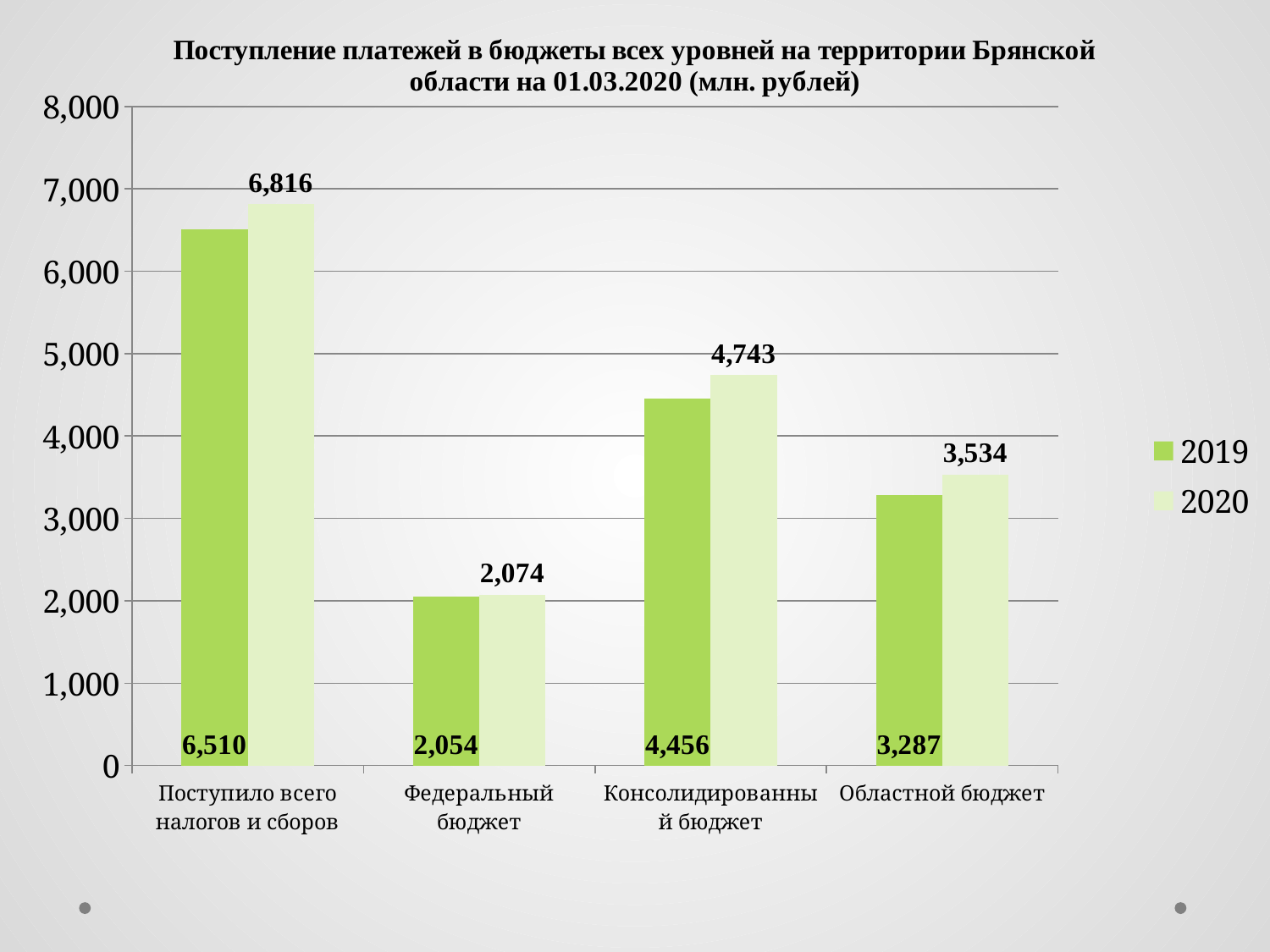
What is the difference between the 2020 and 2019 values for Поступило всего налогов и сборов? 306 What kind of chart is shown on the slide? Bar chart Which category has the highest 2019 value? Поступило всего налогов и сборов How many series does the legend list? 2 What is the 2020 value for Консолидированный бюджет? 4,743 Which category has the lowest 2020 value? Федеральный бюджет What is the difference between the 2020 and 2019 values for Областной бюджет? 247 Which is larger: the 2019 value for Консолидированный бюджет or the 2020 value for Областной бюджет? 2019 value for Консолидированный бюджет What is the 2019 value for Федеральный бюджет? 2,054 How many categories are shown on the x axis? 4 What is the 2020 value for Поступило всего налогов и сборов? 6,816 What is the 2019 value for Областной бюджет? 3,287